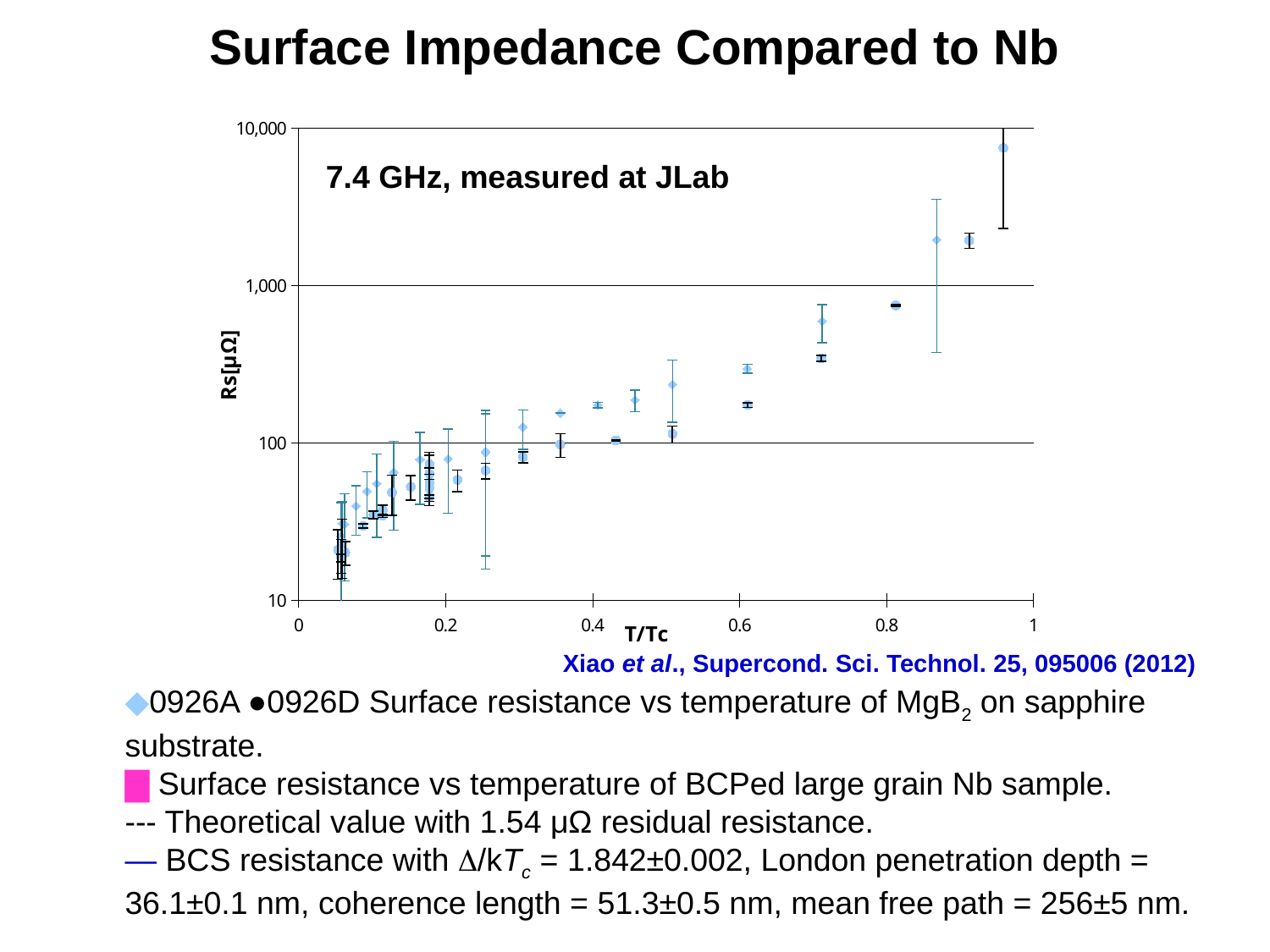
Is the data point near T/Tc = 0.9 greater or less than 1,000 μΩ? greater How many MgB2 samples (0926A and 0926D) are plotted in the chart? 2 Is the data point near T/Tc = 0.4 greater or less than 100 μΩ? greater What kind of chart is shown on the slide? scatter chart What frequency and measurement location are annotated inside the chart? 7.4 GHz, measured at JLab Which data point has the highest surface resistance: the one near T/Tc = 0.96 or the one near T/Tc = 0.8? the one near T/Tc = 0.96 Are the data points near T/Tc = 0.05 greater or less than 100 μΩ? less What is the label of the y axis of the chart? Rs[μΩ] Do the surface resistance values rise or fall as T/Tc increases along the x axis? rise